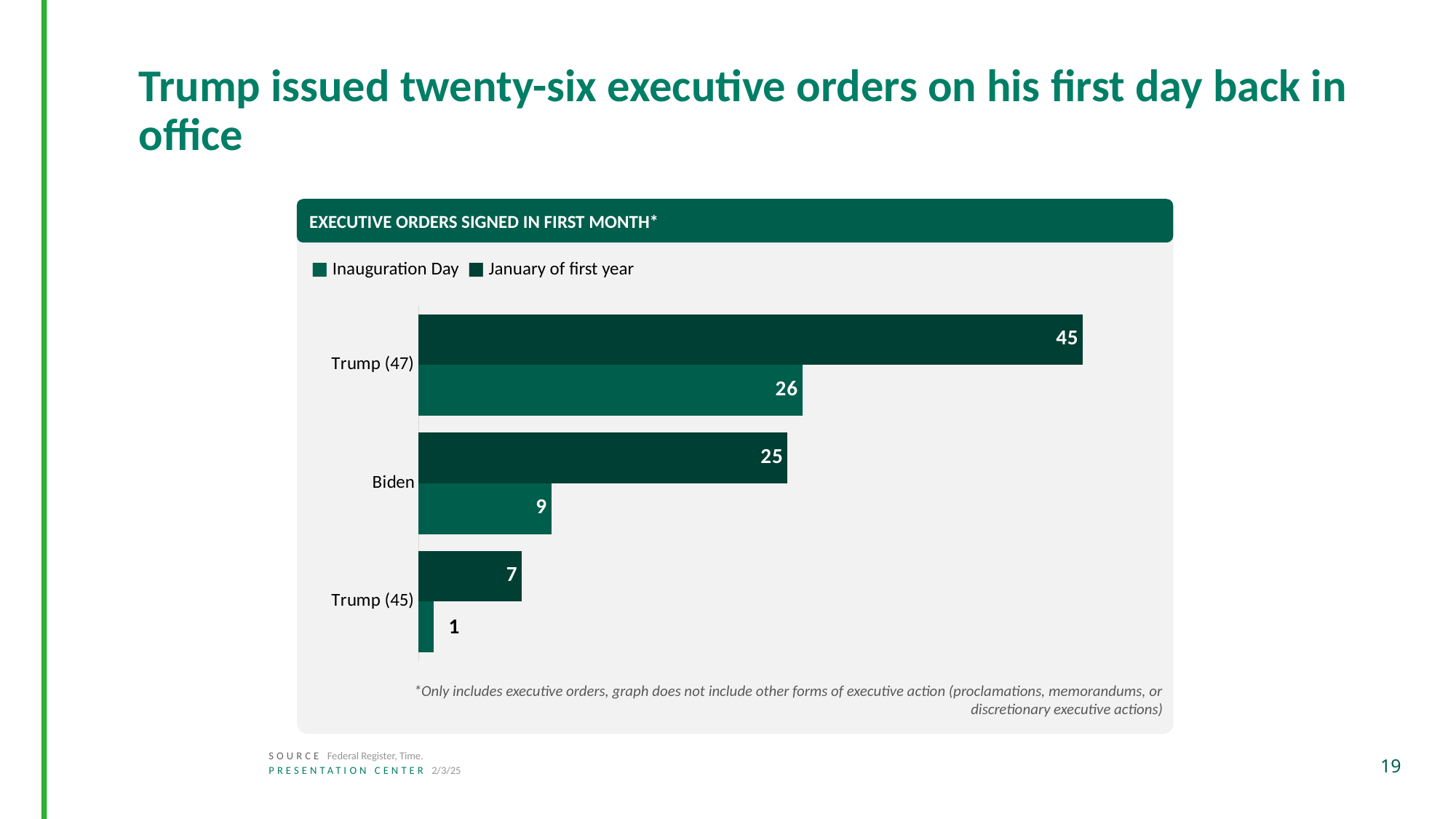
Which president has the highest value for January of first year? Trump (47) Which is larger: Trump (47)'s Inauguration Day value or Biden's January of first year value? Trump (47)'s Inauguration Day value How many series does the legend list? 2 Which president has the lowest value for Inauguration Day? Trump (45) What is the difference between Biden's Inauguration Day value and Trump (45)'s Inauguration Day value? 8 How many executive orders did Trump (47) sign on Inauguration Day? 26 What is the difference between Trump (47)'s and Biden's January of first year values? 20 What is the title of the chart? EXECUTIVE ORDERS SIGNED IN FIRST MONTH* How many executive orders did Trump (45) sign on Inauguration Day? 1 What kind of chart is shown on the slide? Bar chart How many executive orders did Biden sign in January of his first year? 25 How many presidents (categories) are shown in the chart? 3